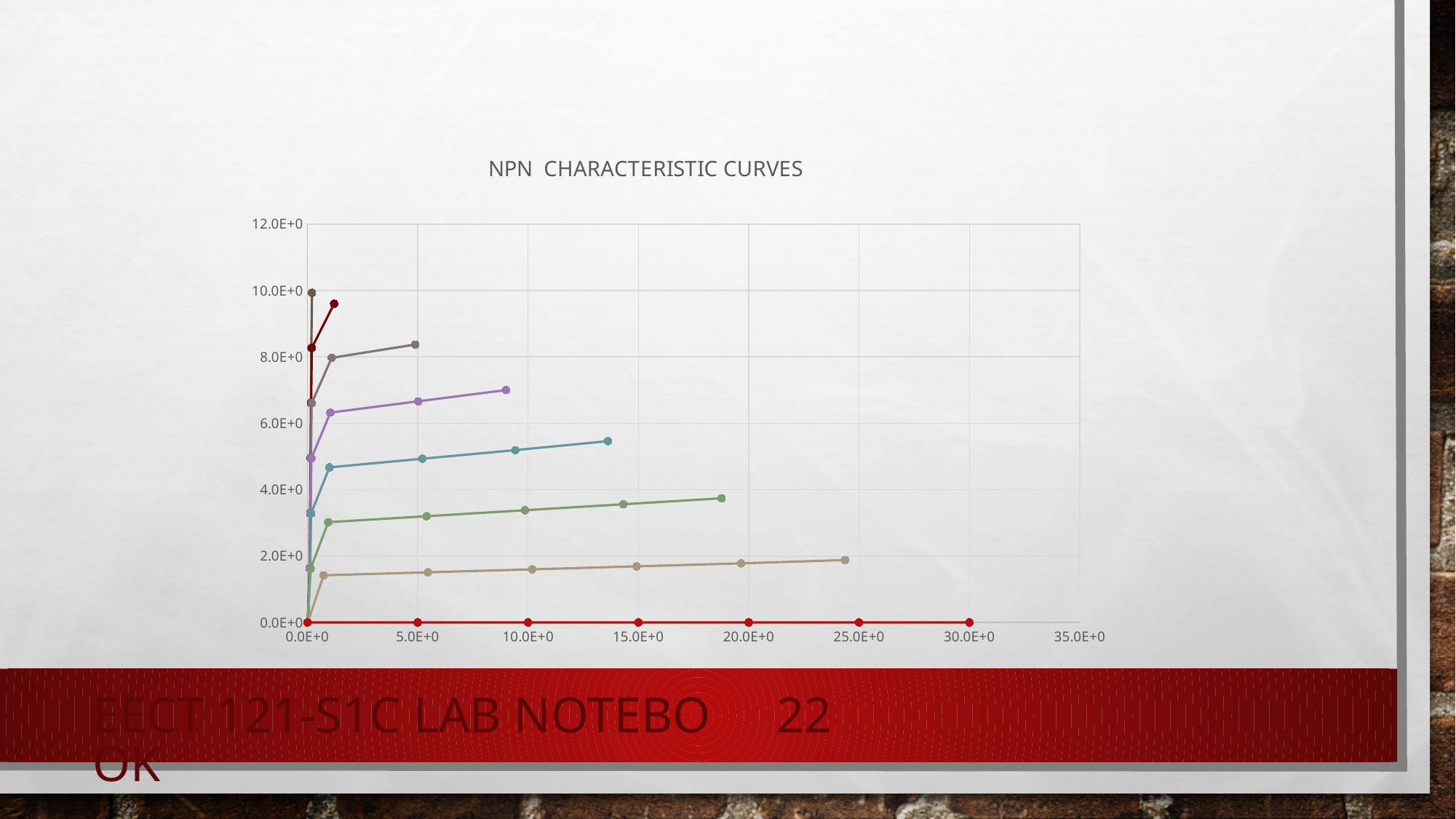
Is the value of the dark red series at its rightmost point greater or less than 8.0E+0? greater What is the highest value labelled on the vertical axis? 12.0E+0 Is the value of the purple series at its rightmost point greater or less than 6.0E+0? greater Does the tan (light brown) series rise or fall as the x-axis value increases beyond 5.0E+0? rise What is the highest value labelled on the horizontal axis? 35.0E+0 What kind of chart is shown on the slide? line chart Is the value of the tan (light brown) series at its rightmost point greater or less than 2.0E+0? less Which series reaches the highest value on the chart: the purple series or the dark red series? the dark red series What is the title of the chart? NPN CHARACTERISTIC CURVES What value does the bright red series running along the bottom of the chart hold at every point? 0.0E+0